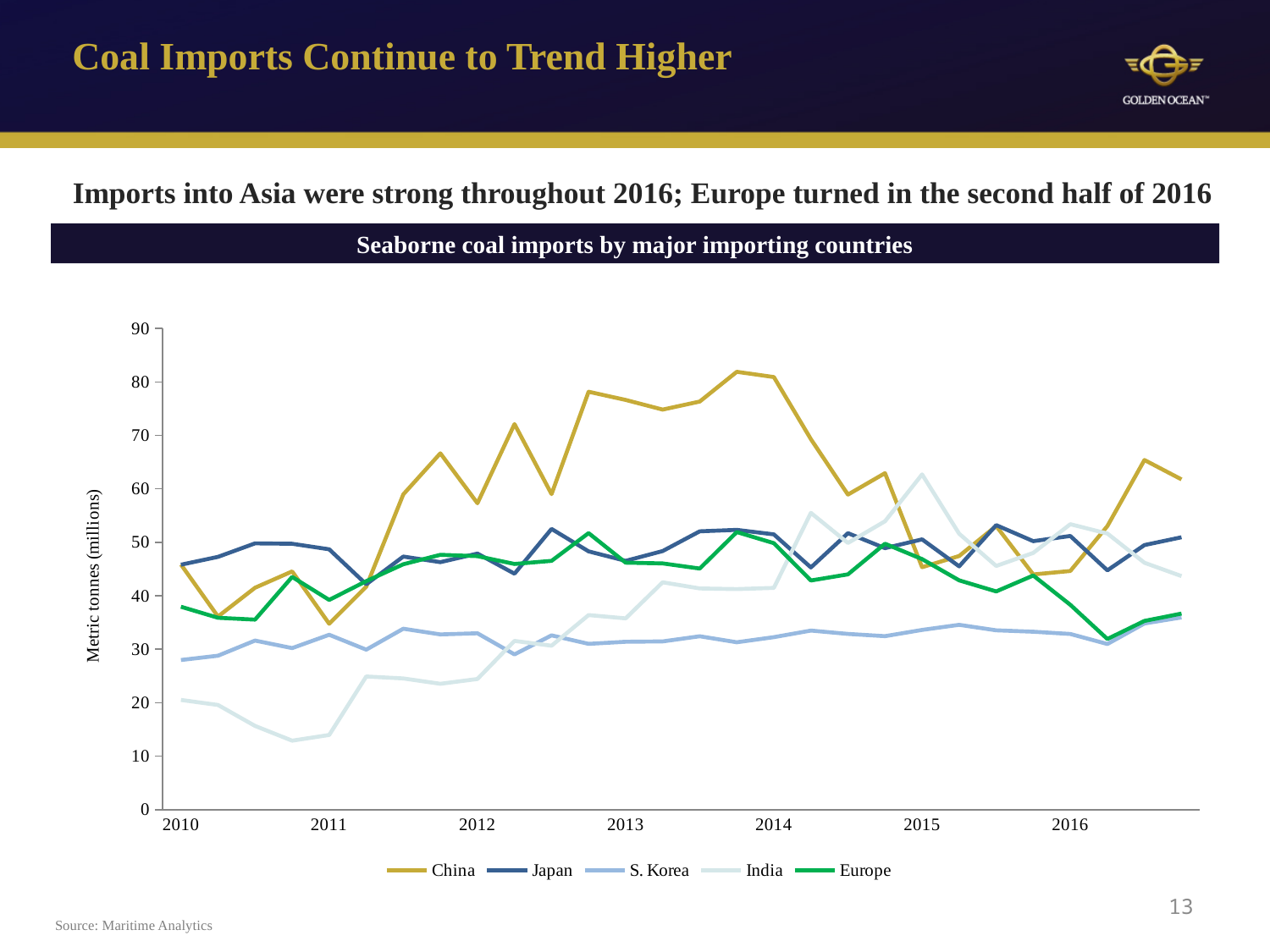
At the 2014 tick, which is larger, the value for China or the value for S. Korea? China Which series has the highest value at the 2014 tick? China How many series does the legend list? 5 How many year labels appear on the x axis? 7 Is the value for Japan at the 2010 tick greater or less than 40? greater Is the value for India at the 2010 tick greater or less than 30? less Which series has the lowest value at the 2010 tick? India Which countries or regions are listed in the chart legend? China, Japan, S. Korea, India, Europe Does the India series generally rise or fall from 2010 to 2016? rise Is the peak value for China (around late 2013) greater or less than 70? greater What kind of chart is shown on the slide? line chart What is the label on the vertical axis of the chart? Metric tonnes (millions)